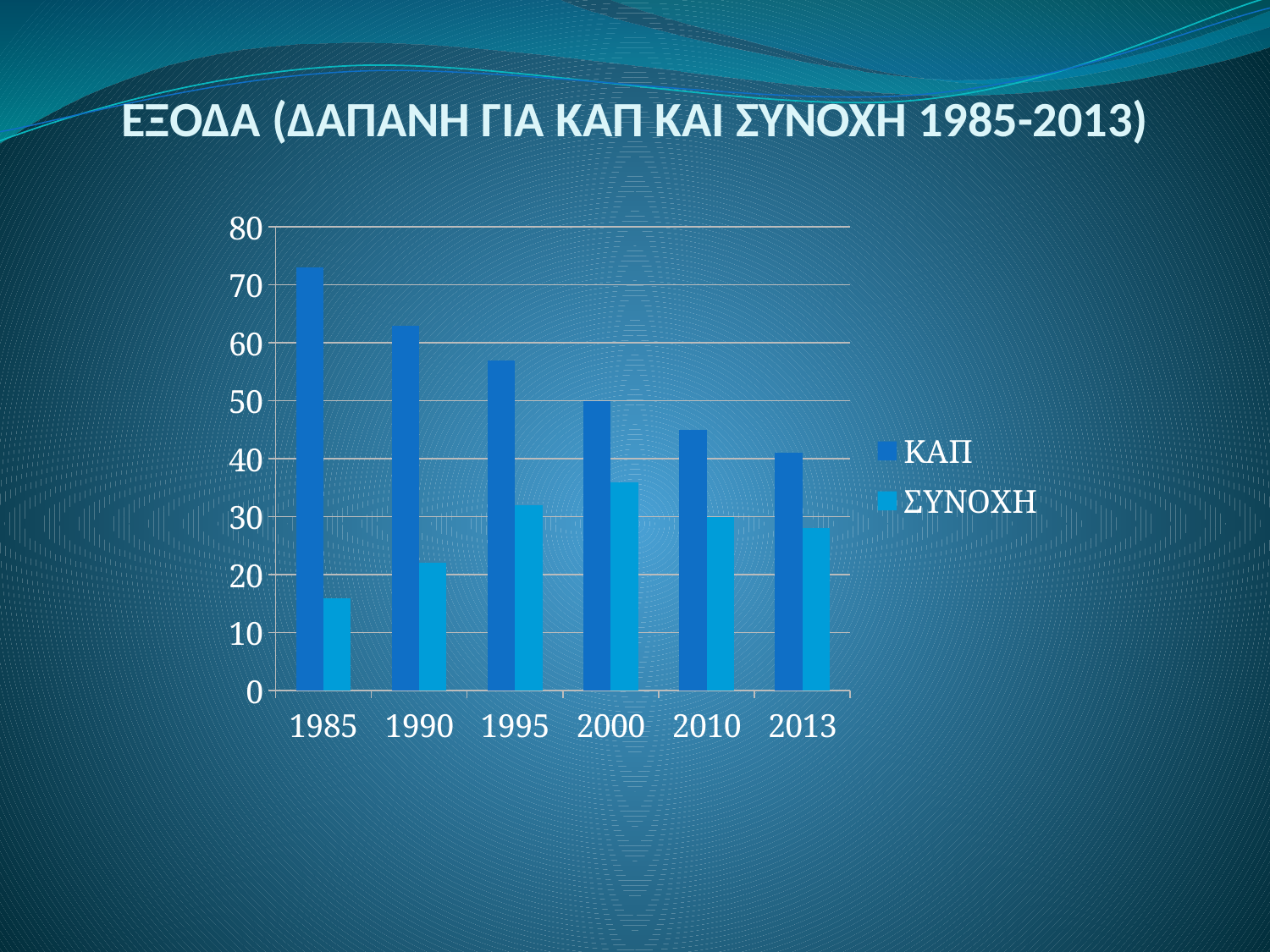
What kind of chart is shown on the slide? bar chart Which year has the highest value for ΚΑΠ? 1985 How many series does the legend list? 2 How many years are shown on the x axis? 6 Is the value for ΣΥΝΟΧΗ in 1985 greater or less than 20? less Which year has the highest value for ΣΥΝΟΧΗ? 2000 Do the values for ΚΑΠ rise or fall from 1985 to 2013? fall Which is larger in 1990, ΚΑΠ or ΣΥΝΟΧΗ? ΚΑΠ Which year has the lowest value for ΚΑΠ? 2013 Is the value for ΚΑΠ in 1985 greater or less than 70? greater Which year has the lowest value for ΣΥΝΟΧΗ? 1985